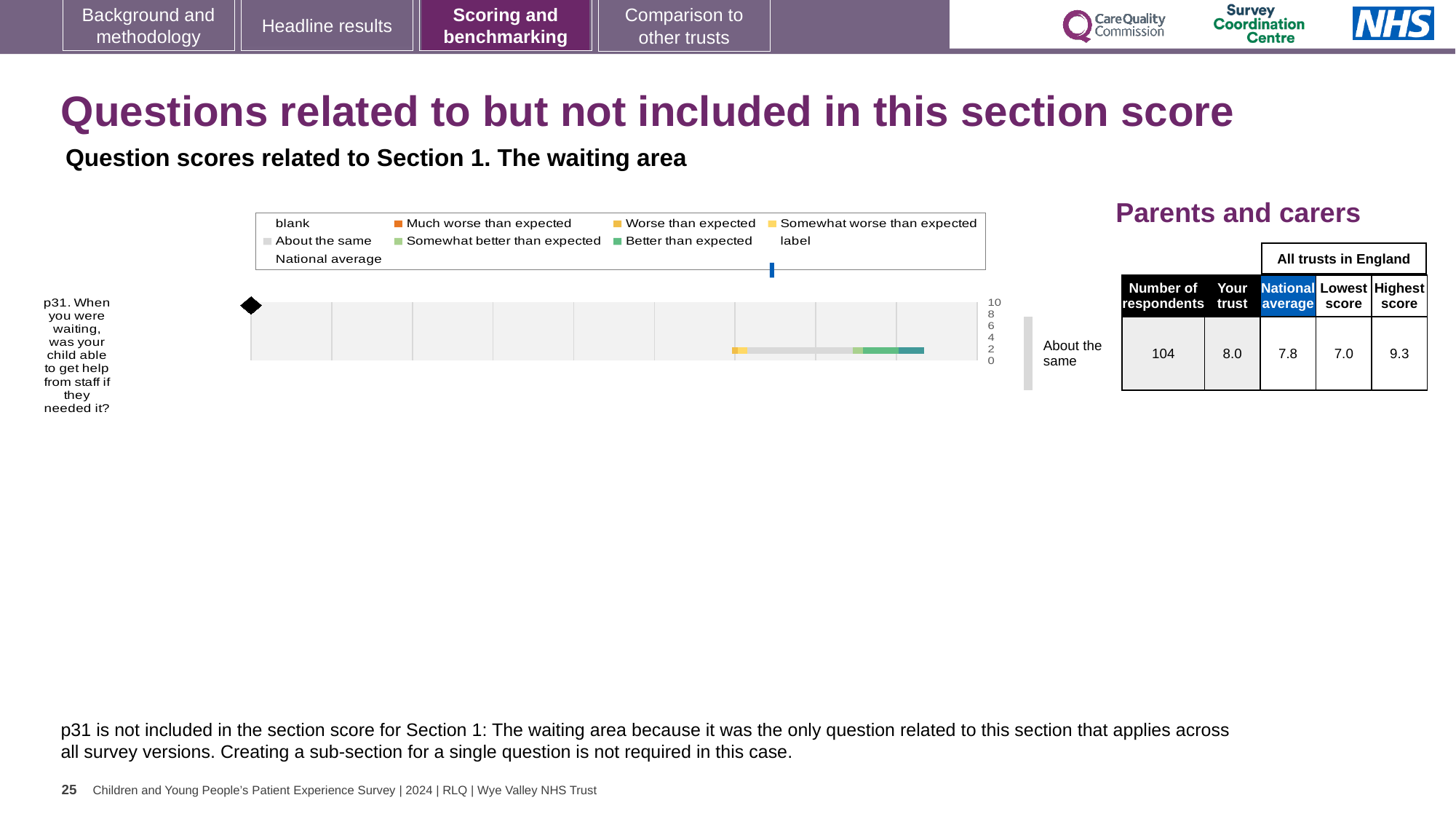
For p31, what is the difference between the highest score and the lowest score among all trusts in England? 2.3 In the Parents and carers table, what is the number of respondents for p31? 104 What kind of chart is shown for question p31? bar chart In the Parents and carers table, what is the highest score among all trusts in England for p31? 9.3 How many survey questions are plotted in the chart? 1 In the Parents and carers table, what is the 'Your trust' score for p31? 8.0 In the Parents and carers table, what is the national average score for p31? 7.8 In the Parents and carers table, what is the lowest score among all trusts in England for p31? 7.0 What benchmark category is written to the right of the p31 bar? About the same For p31, which is larger: the 'Your trust' score or the national average? Your trust For p31, how much higher is the 'Your trust' score than the national average? 0.2 Which colour in the legend represents 'Much worse than expected'? orange